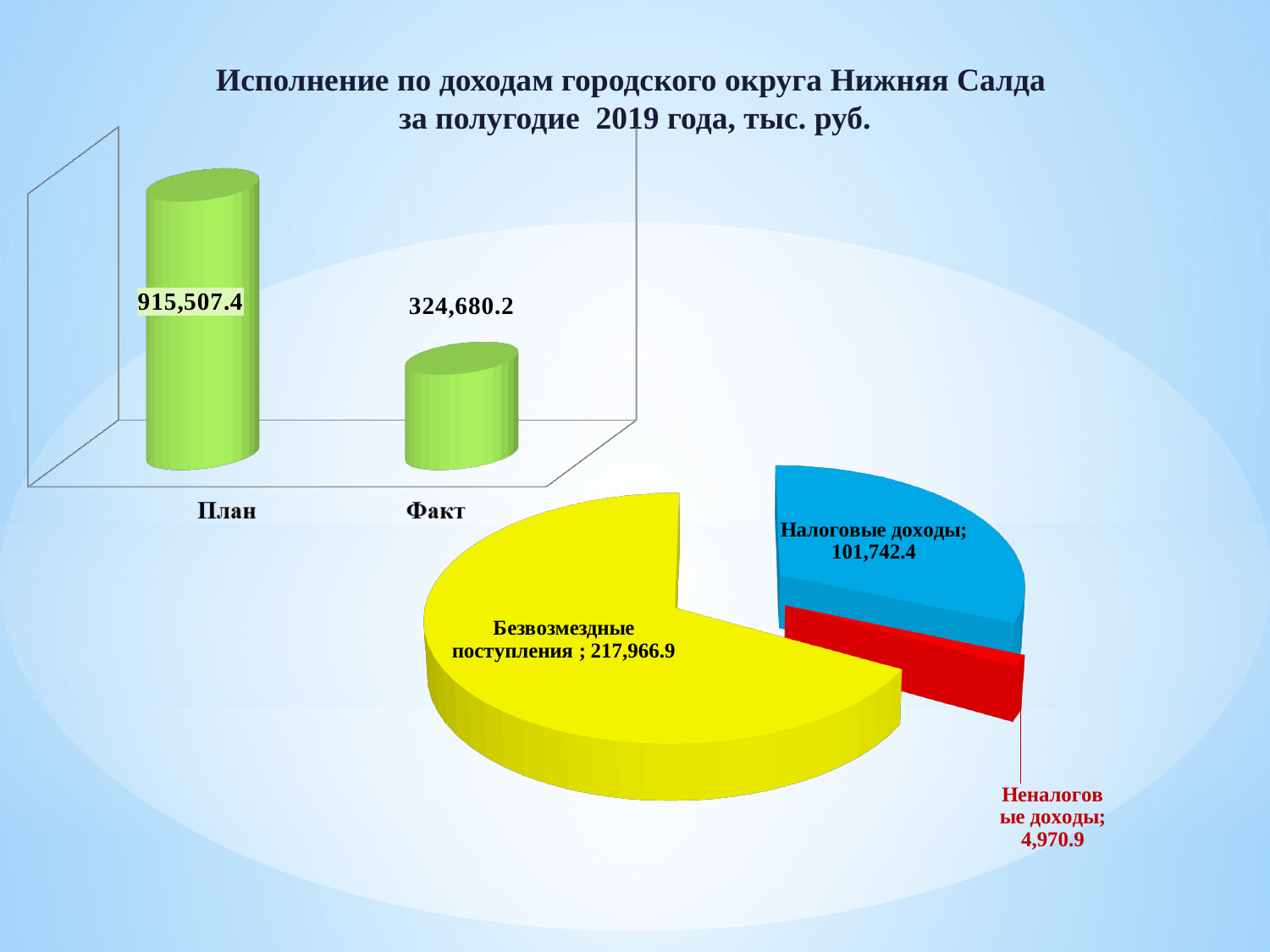
What kind of chart is the chart on the left of the slide? Bar chart On the pie chart on the right, which category has the smallest value? Неналоговые доходы On the bar chart on the left, how many categories are shown? 2 On the bar chart on the left, what is the value for План? 915,507.4 On the pie chart on the right, which category has the largest value? Безвозмездные поступления On the bar chart on the left, which category has the higher value, План or Факт? План On the pie chart on the right, what is the value for Неналоговые доходы? 4,970.9 On the pie chart on the right, what is the value for Налоговые доходы? 101,742.4 On the pie chart on the right, what is the difference between Налоговые доходы and Неналоговые доходы? 96,771.5 On the bar chart on the left, what is the difference between the План and Факт values? 590,827.2 On the pie chart on the right, what is the value for Безвозмездные поступления? 217,966.9 On the bar chart on the left, what is the value for Факт? 324,680.2